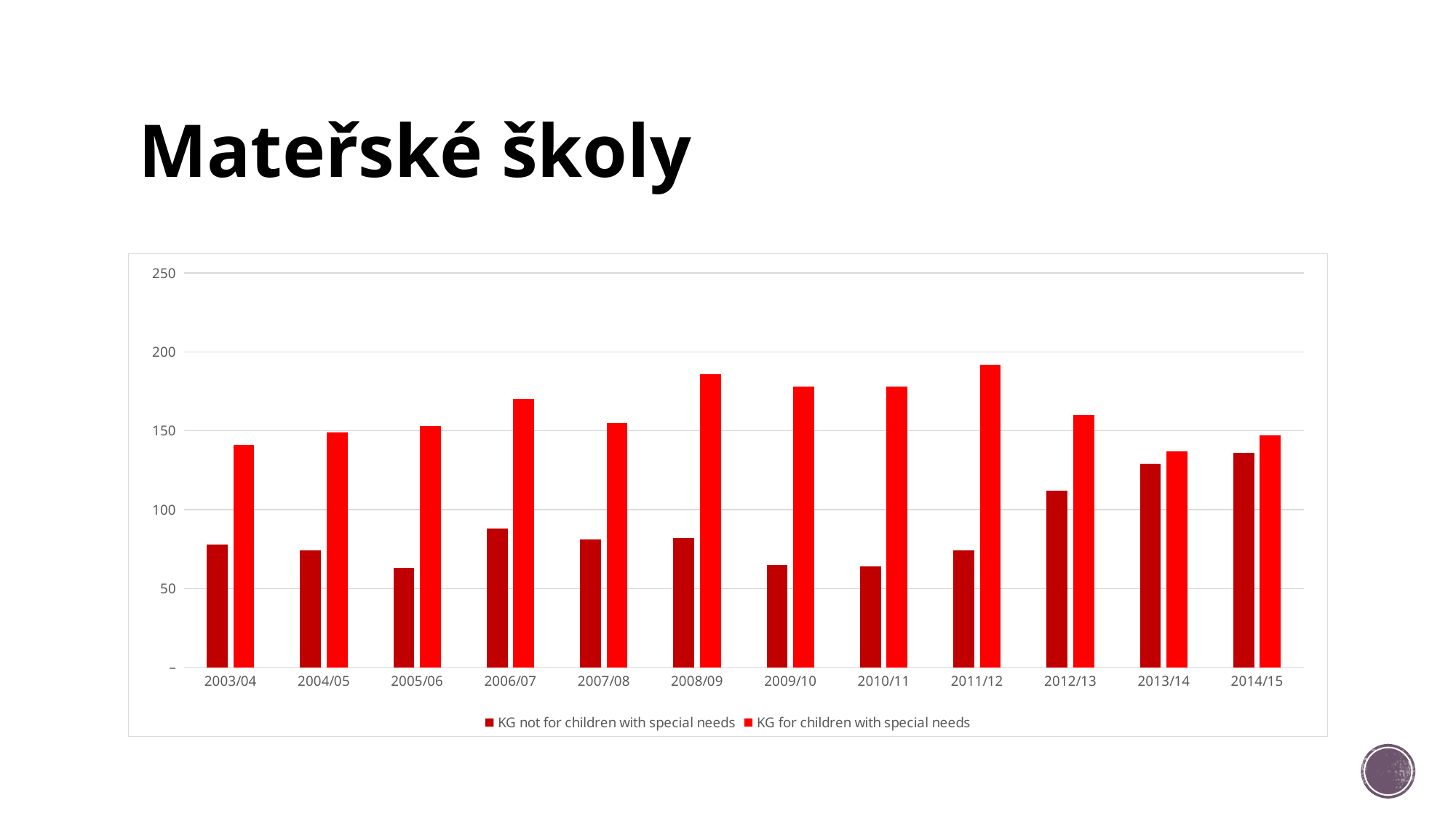
Is the value for KG for children with special needs in 2011/12 greater or less than 200? less How many school years are shown on the x axis? 12 What is the title of the slide containing the chart? Mateřské školy In which school year is the value for KG not for children with special needs highest? 2014/15 Which is larger: the value for KG for children with special needs in 2006/07 or in 2007/08? 2006/07 Is the value for KG not for children with special needs in 2012/13 greater or less than 100? greater In which school year is the value for KG for children with special needs highest? 2011/12 Is the value for KG not for children with special needs in 2005/06 greater or less than 100? less How many series does the legend list? 2 Do the values for KG not for children with special needs rise or fall from 2011/12 to 2014/15? rise What kind of chart is shown on the slide? bar chart